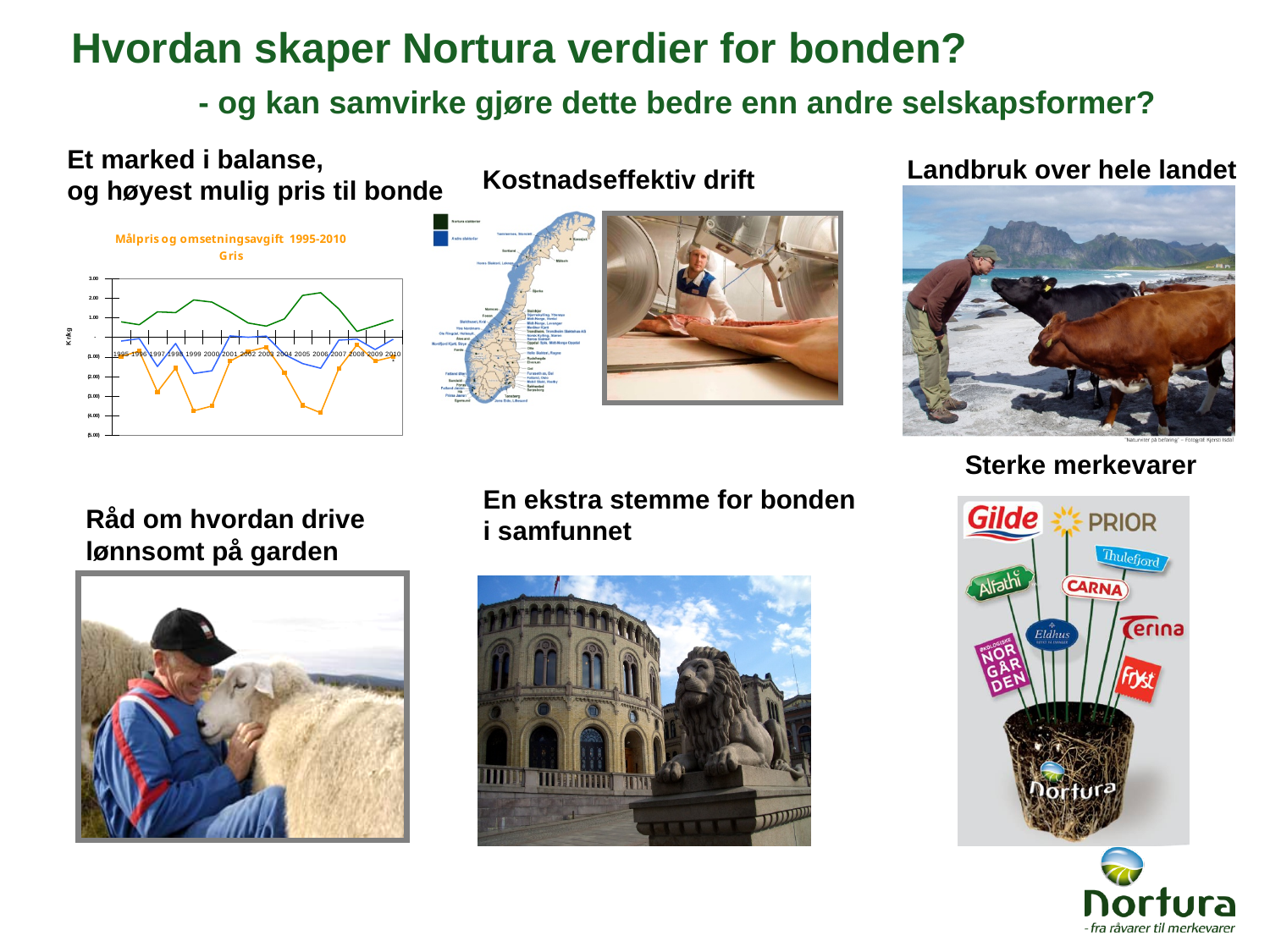
What is the highest tick value shown on the vertical axis of the chart? 3.00 How many years are plotted along the x axis of the chart? 16 What is the title of the chart on the slide? Målpris og omsetningsavgift 1995-2010 Gris Is the value of the green line in 2007 greater or less than 1.00? greater How many lines are plotted in the chart? 3 What kind of chart is shown under the heading 'Et marked i balanse, og høyest mulig pris til bonde'? line chart What is the first year shown on the x axis of the chart? 1995 What unit is shown on the vertical axis of the chart? Kr/kg What is the last year shown on the x axis of the chart? 2010 Is the value of the orange line in 2006 greater or less than (2.00)? less In 2005, which line is higher in the chart, the green line or the orange line? the green line